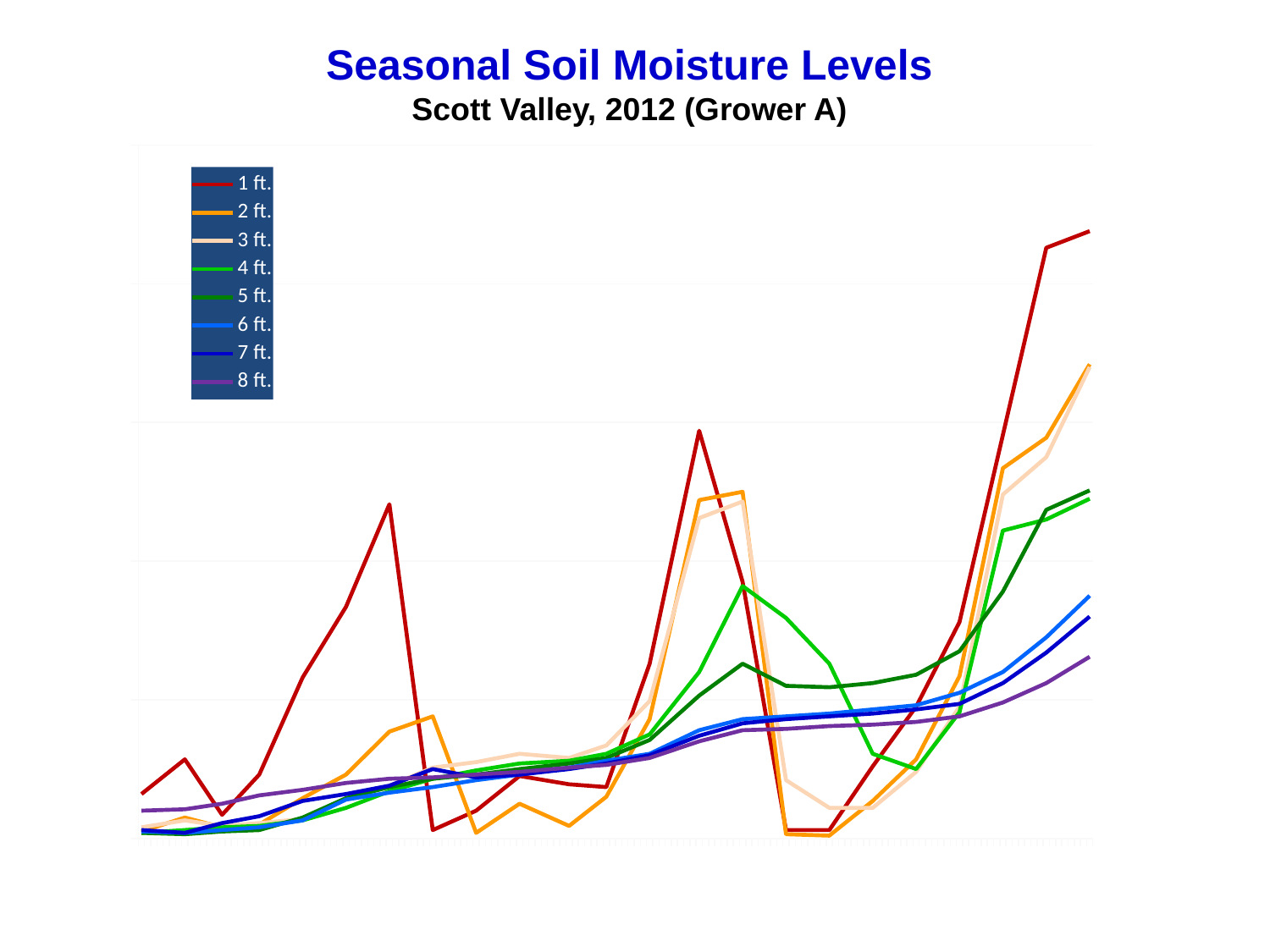
What is the title of the chart? Seasonal Soil Moisture Levels Which series is drawn in purple? 8 ft. What kind of chart is shown on the slide? line chart Which series reaches the highest point on the chart? 1 ft. At the right-hand end of the chart, which is higher: the 2 ft. line or the 6 ft. line? 2 ft. At the right-hand end of the chart, which is higher: the 1 ft. line or the 8 ft. line? 1 ft. How many series does the legend list? 8 Does the 8 ft. line generally rise or fall from left to right? rise What subtitle appears below the chart title? Scott Valley, 2012 (Grower A) Which series is lowest at the right-hand end of the chart? 8 ft.